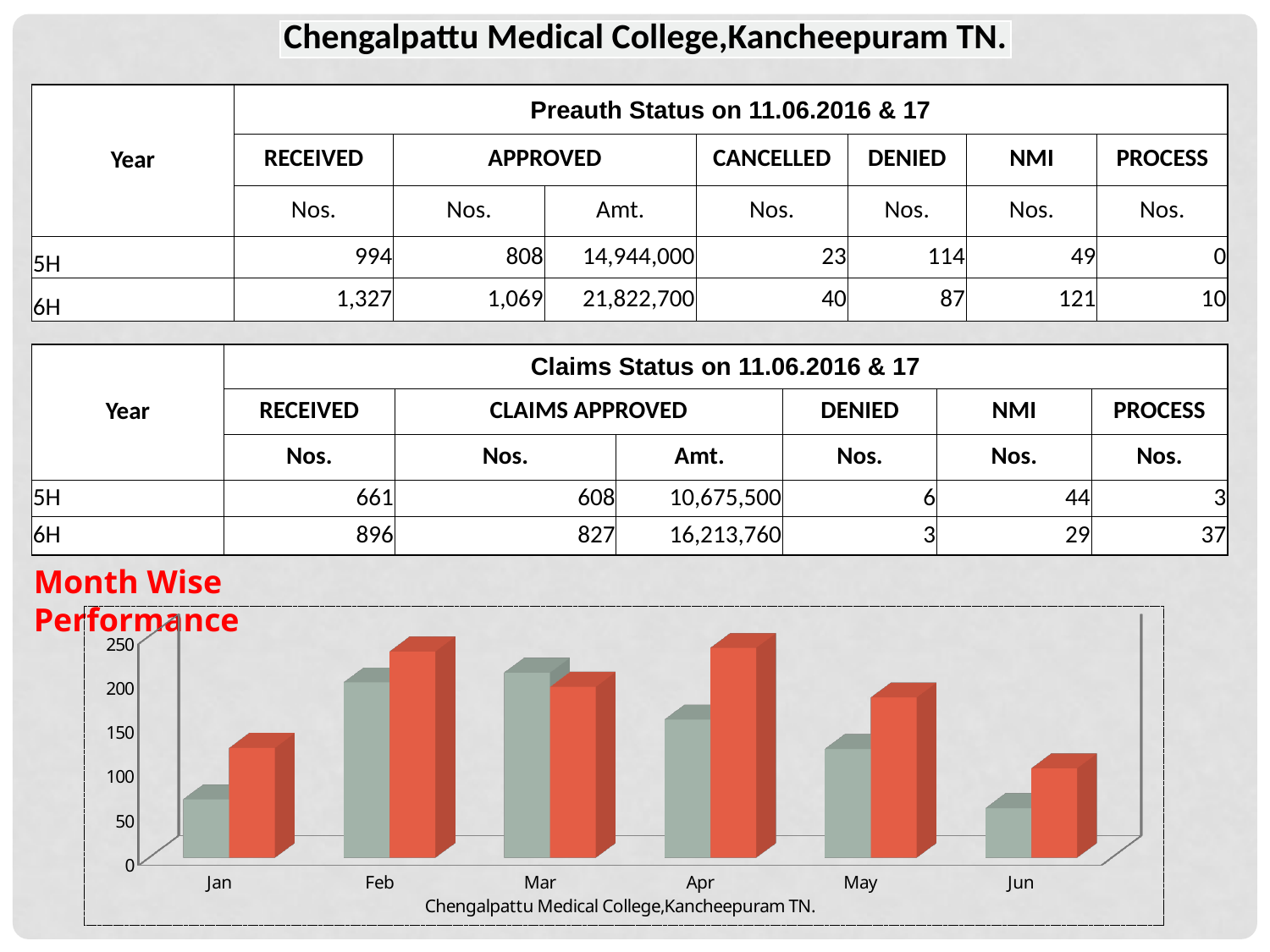
Is the value of the red bar for Feb greater or less than 200? greater Is the value of the red bar for Jan greater or less than 100? greater What text appears as the chart's title below the x axis? Chengalpattu Medical College,Kancheepuram TN. Is the value of the grey bar for Jun greater or less than 100? less In Mar, which bar is taller, the grey bar or the red bar? the grey bar In which month is the red bar the lowest? Jun What kind of chart is shown on the slide? bar chart How many bars are plotted for each month in the chart? 2 How many months are shown on the x axis of the chart? 6